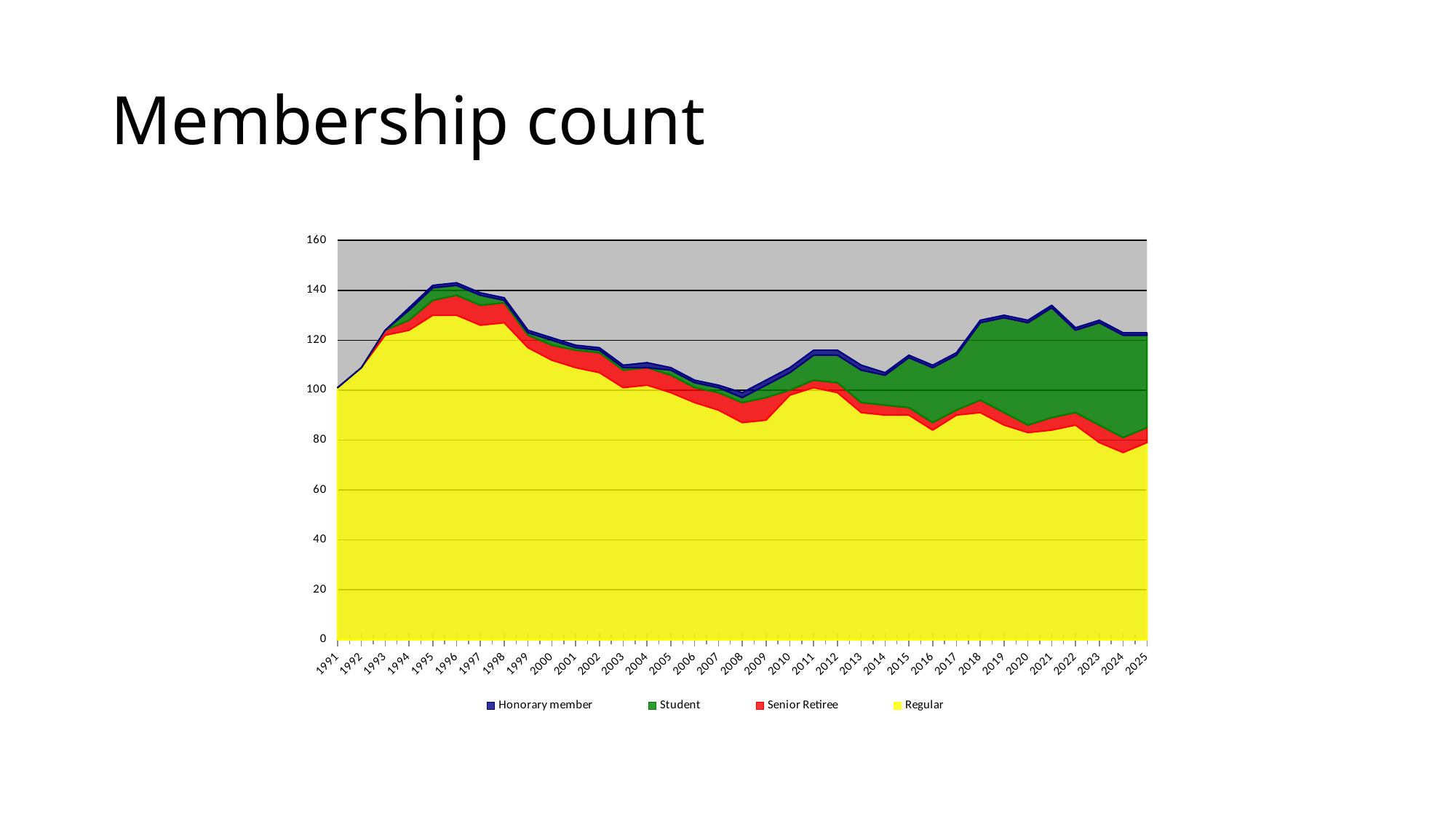
Is the total membership in 1996 greater or less than 140? greater Is the Regular membership in 2024 greater or less than 80? less Is the total membership in 2021 greater or less than 120? greater Which series is shown in yellow? Regular How many series does the legend list? 4 Does the Regular membership rise or fall from 1996 to 2024? fall In which year is the total membership highest? 1996 In which year is the total membership lowest? 2008 How many years are shown along the x axis? 35 What is the title of the slide containing the chart? Membership count What kind of chart is shown on the slide? Stacked area chart